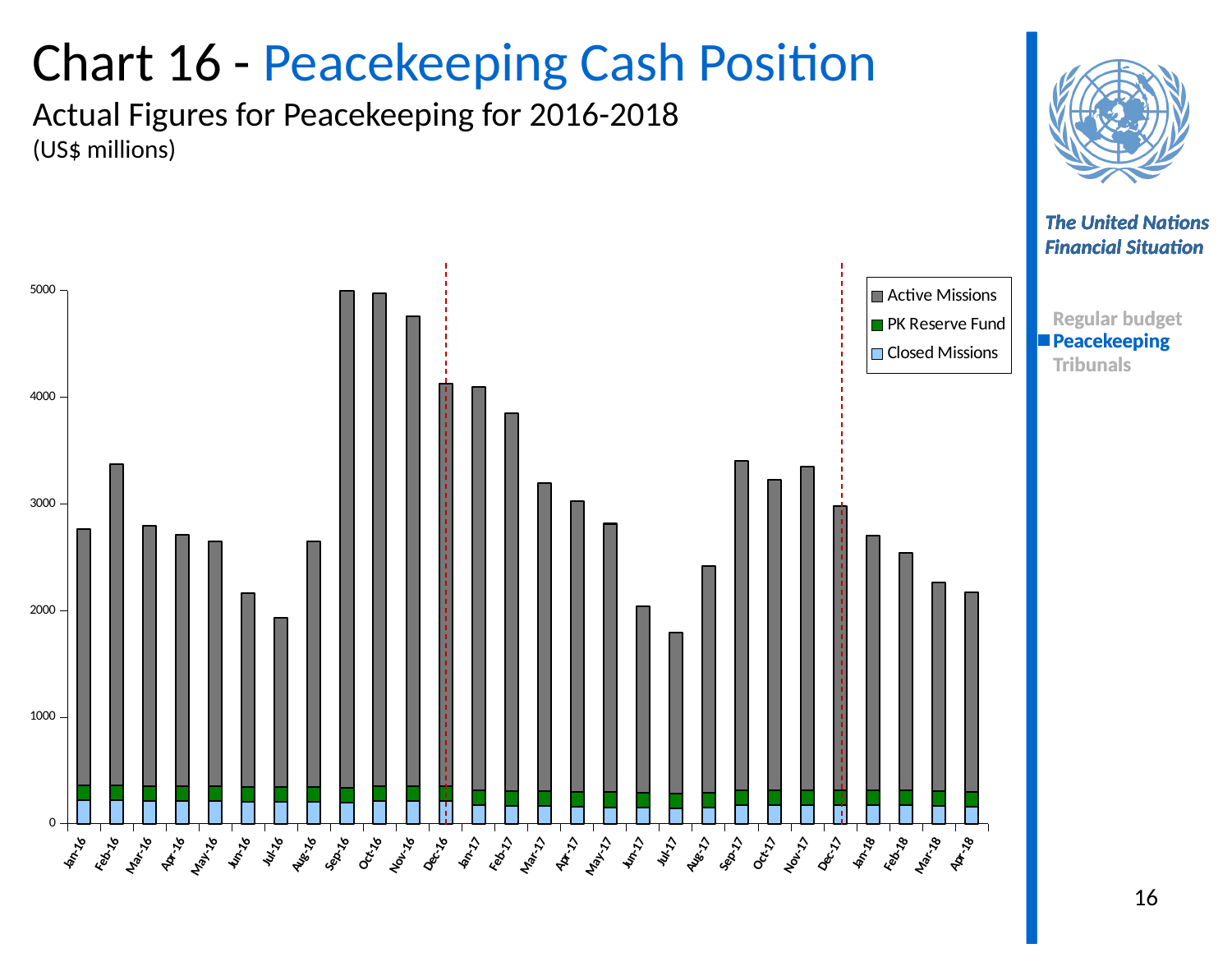
Which has the larger total, Jan-17 or Feb-17? Jan-17 Is the total value for Jan-16 greater or less than 3000? less Is the total value for Feb-16 greater or less than 3000? greater What kind of chart is shown on the slide? Stacked bar chart How many months (categories) are plotted along the x axis? 28 Is the total value for Jul-17 greater or less than 2000? less Which has the larger total, Aug-17 or Sep-17? Sep-17 How many series does the legend list? 3 Do the total values rise or fall from Dec-16 to Jul-17? fall In what units are the values on the chart expressed? US$ millions Which month has the lowest total cash position? Jul-17